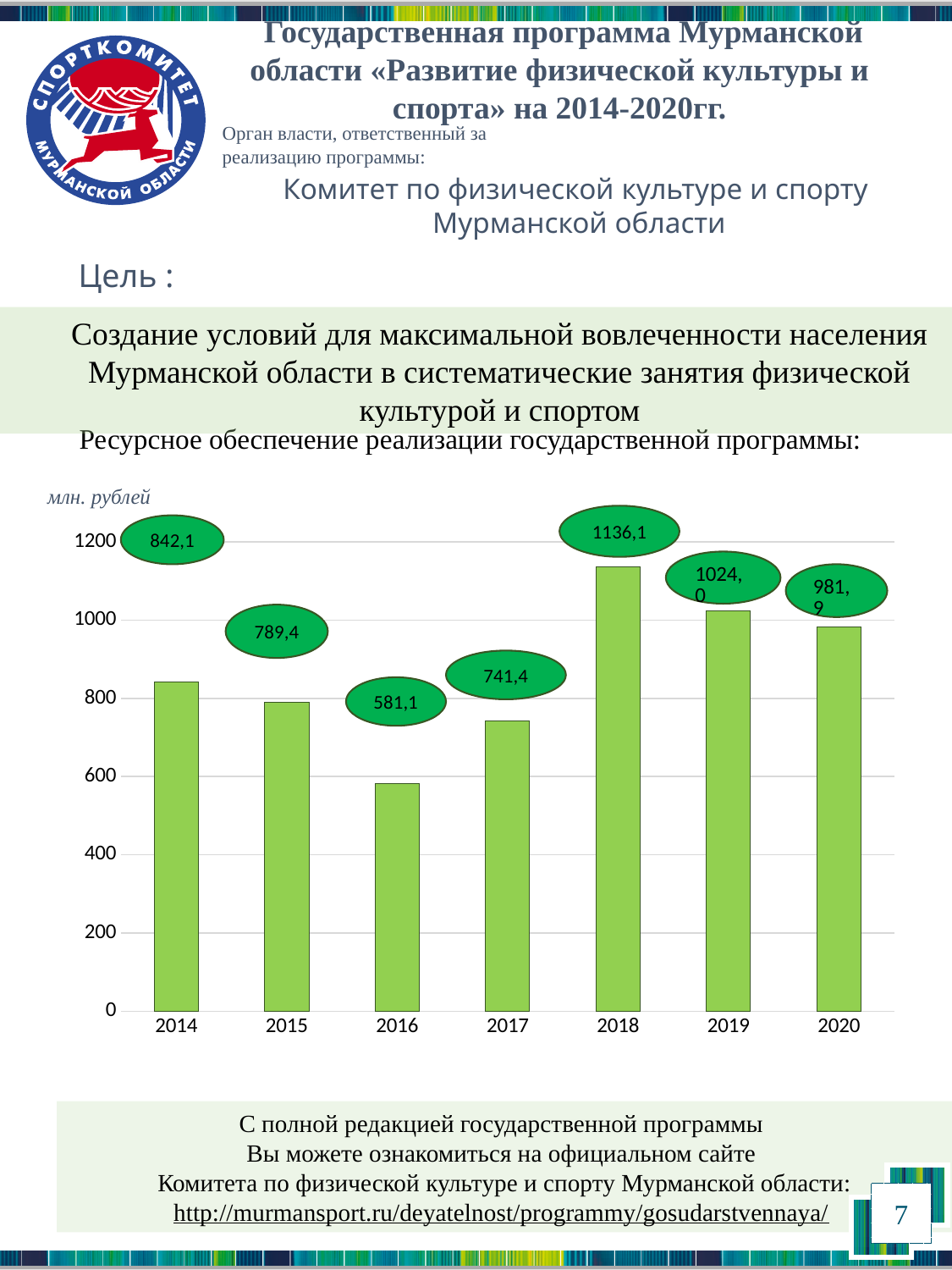
What is the value for 2016 in the chart? 581,1 What is the difference between the values for 2018 and 2019? 112,1 What unit is indicated above the chart's y axis? млн. рублей What is the value for 2014 in the chart? 842,1 Which is larger, the value for 2015 or the value for 2017? 2015 Is the value for 2020 greater or less than 1000? less Which year has the highest value in the chart? 2018 Do the values rise or fall from 2018 to 2020? fall What is the value for 2018 in the chart? 1136,1 How many years are shown on the x axis of the chart? 7 Which year has the lowest value in the chart? 2016 What type of chart is shown on the slide? bar chart